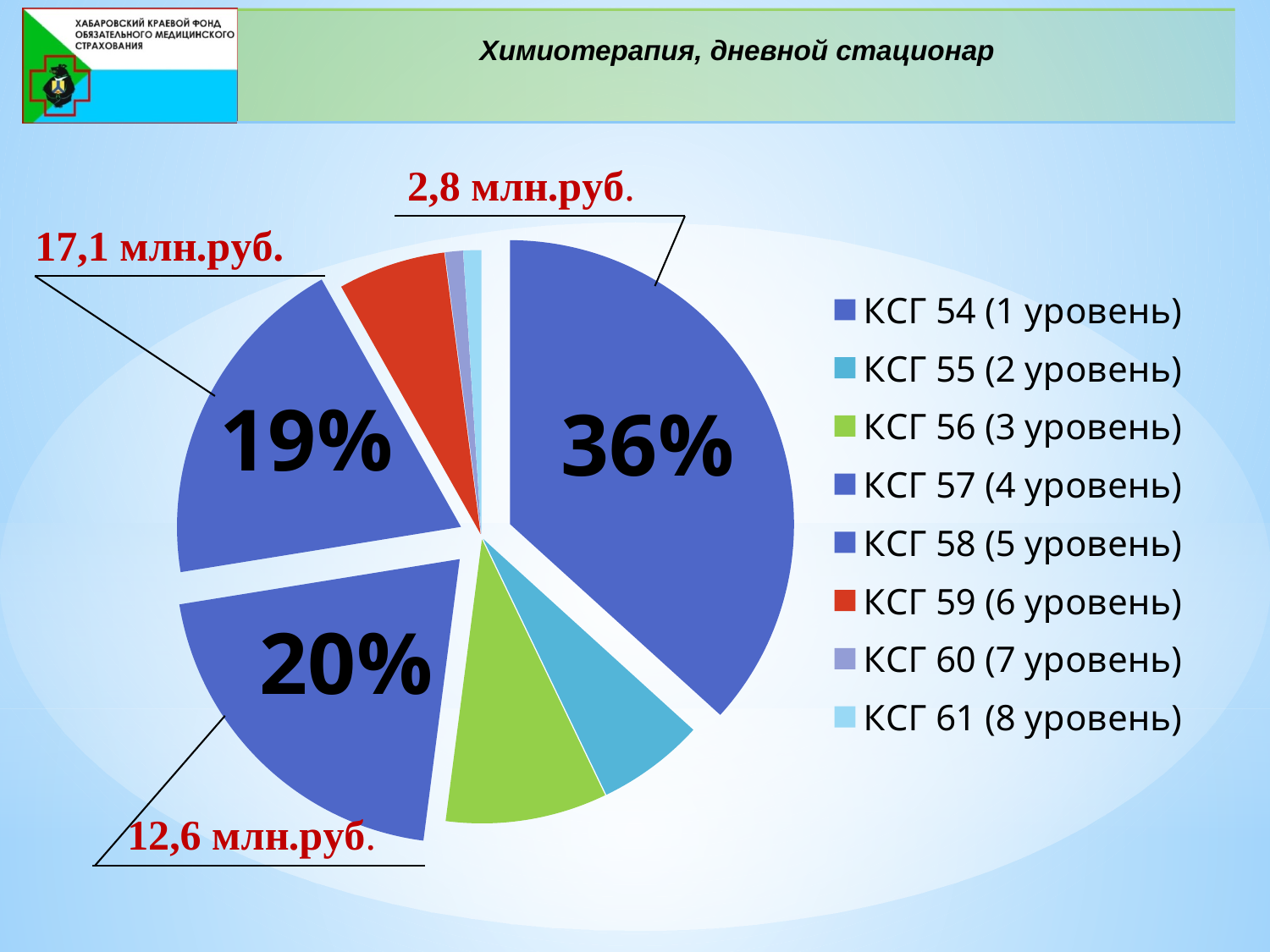
Is the share for КСГ 54 (1 уровень) greater or less than 50%? less What share of the pie does КСГ 58 (5 уровень) have? 19% Which category has the largest slice of the pie? КСГ 54 (1 уровень) By how many percentage points does the share of КСГ 54 (1 уровень) exceed that of КСГ 57 (4 уровень)? 16 percentage points What is the combined share of the three slices with printed percentages (36%, 20% and 19%)? 75% What kind of chart is shown on the slide? pie chart Which slice is larger, КСГ 57 (4 уровень) or КСГ 58 (5 уровень)? КСГ 57 (4 уровень) How many categories does the legend of the pie chart list? 8 What share of the pie does КСГ 54 (1 уровень) have? 36% What is the title of the slide containing the pie chart? Химиотерапия, дневной стационар What share of the pie does КСГ 57 (4 уровень) have? 20% What colour is the slice for КСГ 59 (6 уровень) in the pie chart? red